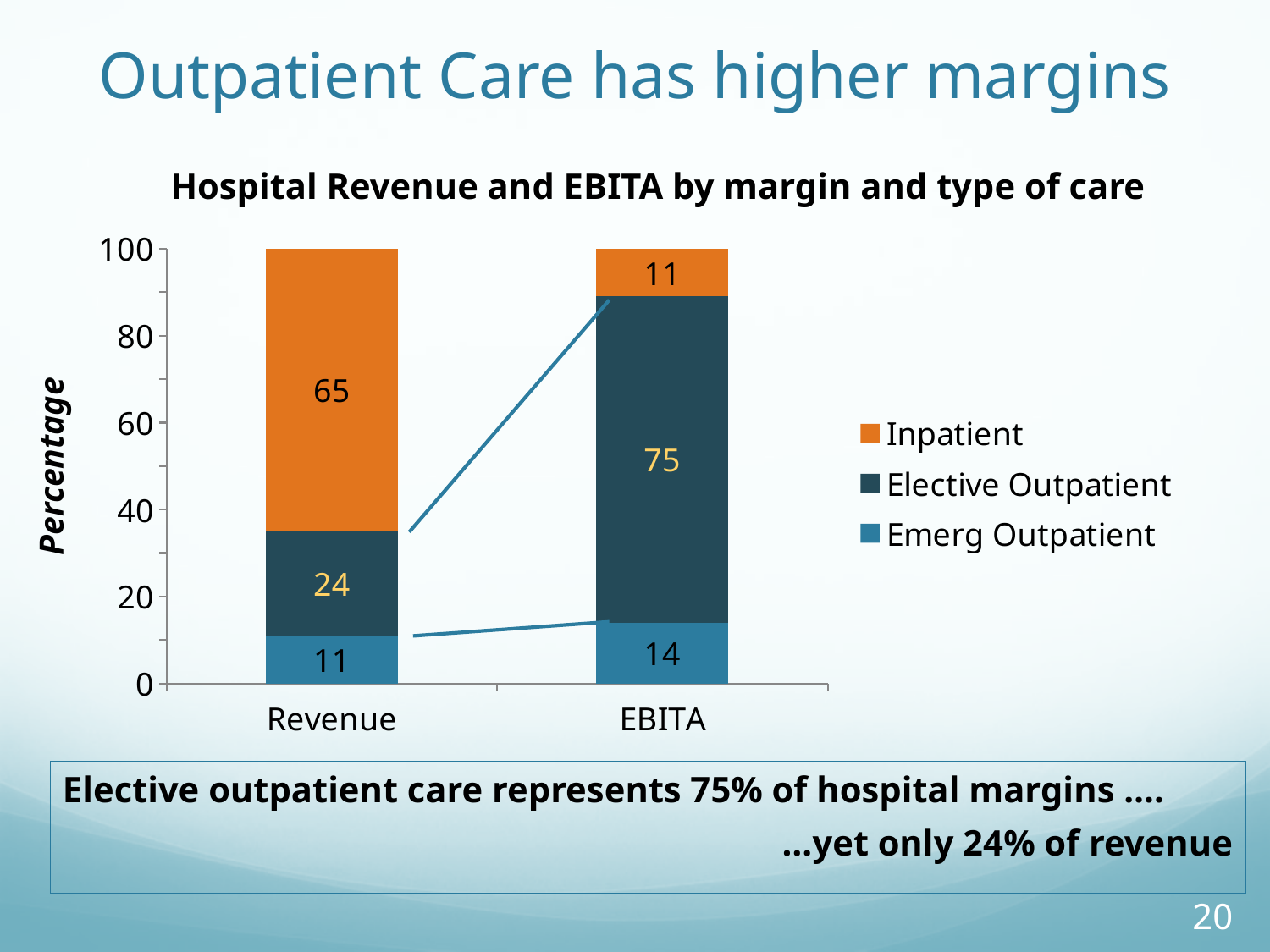
What is the value for Emerg Outpatient in the EBITA bar? 14 How many series does the legend list? 3 What is the value for Elective Outpatient in the EBITA bar? 75 Which series has the largest segment in the EBITA bar? Elective Outpatient Which series has the smallest segment in the Revenue bar? Emerg Outpatient What is the total of the Revenue stacked bar? 100 How many categories are shown on the x axis? 2 What is the value for Inpatient in the Revenue bar? 65 What is the difference between the Elective Outpatient values for EBITA and Revenue? 51 What is the value for Elective Outpatient in the Revenue bar? 24 What kind of chart is shown on the slide? Stacked bar chart Which is larger: Inpatient for Revenue or Inpatient for EBITA? Inpatient for Revenue